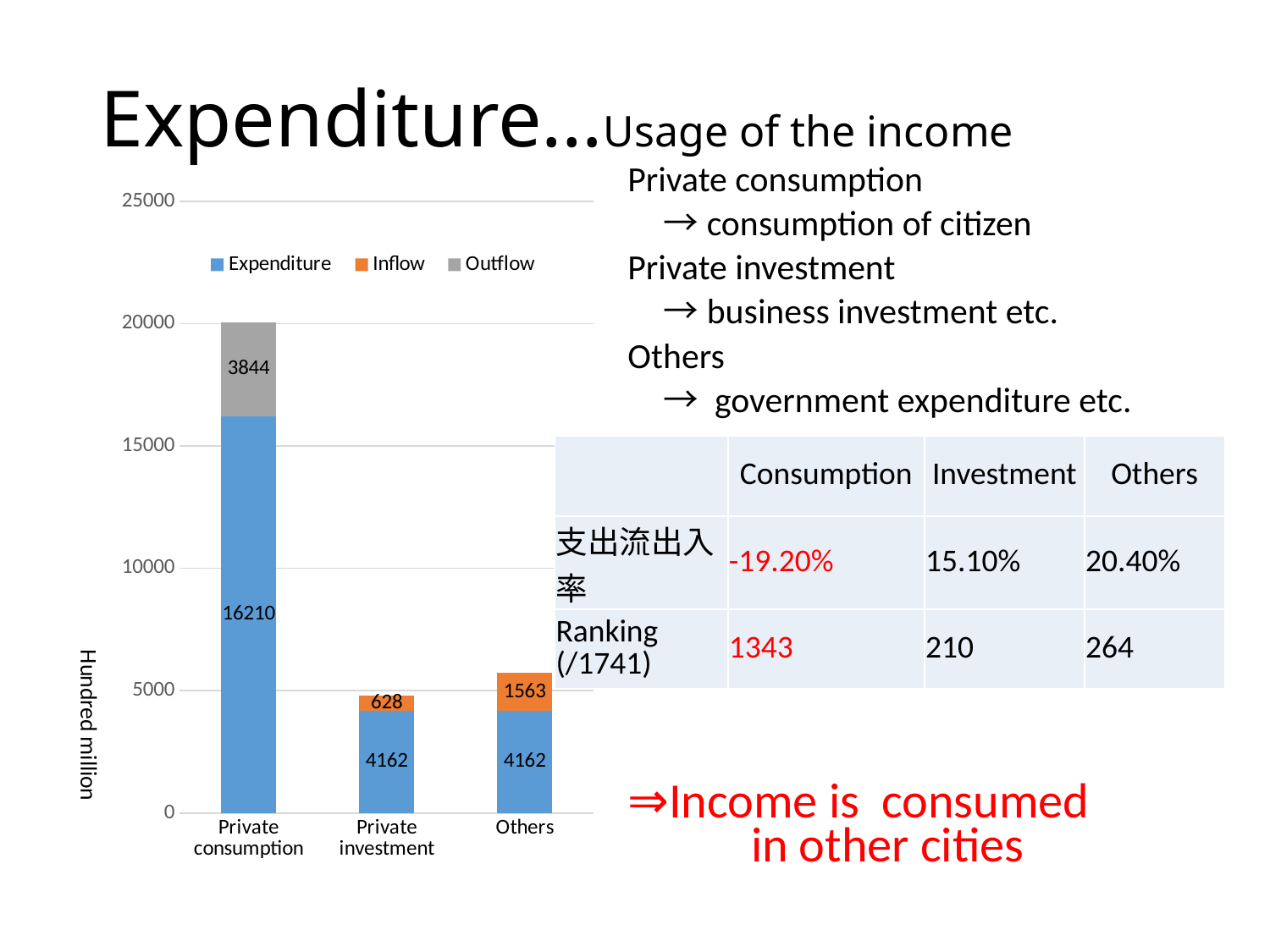
How many series does the legend list? 3 Which is larger, the Inflow for Others or the Inflow for Private investment? Inflow for Others What is the Inflow value for Others? 1563 Which category has the highest Expenditure value? Private consumption What is the Expenditure value for Private consumption? 16210 Is the total stacked bar for Private consumption greater or less than 15000? greater What is the total of the stacked bar for Others? 5725 What is the Outflow value for Private consumption? 3844 What is the Inflow value for Private investment? 628 How many categories are shown on the x axis? 3 What is the difference between the Inflow values for Others and Private investment? 935 What kind of chart is shown on the slide? Stacked bar chart